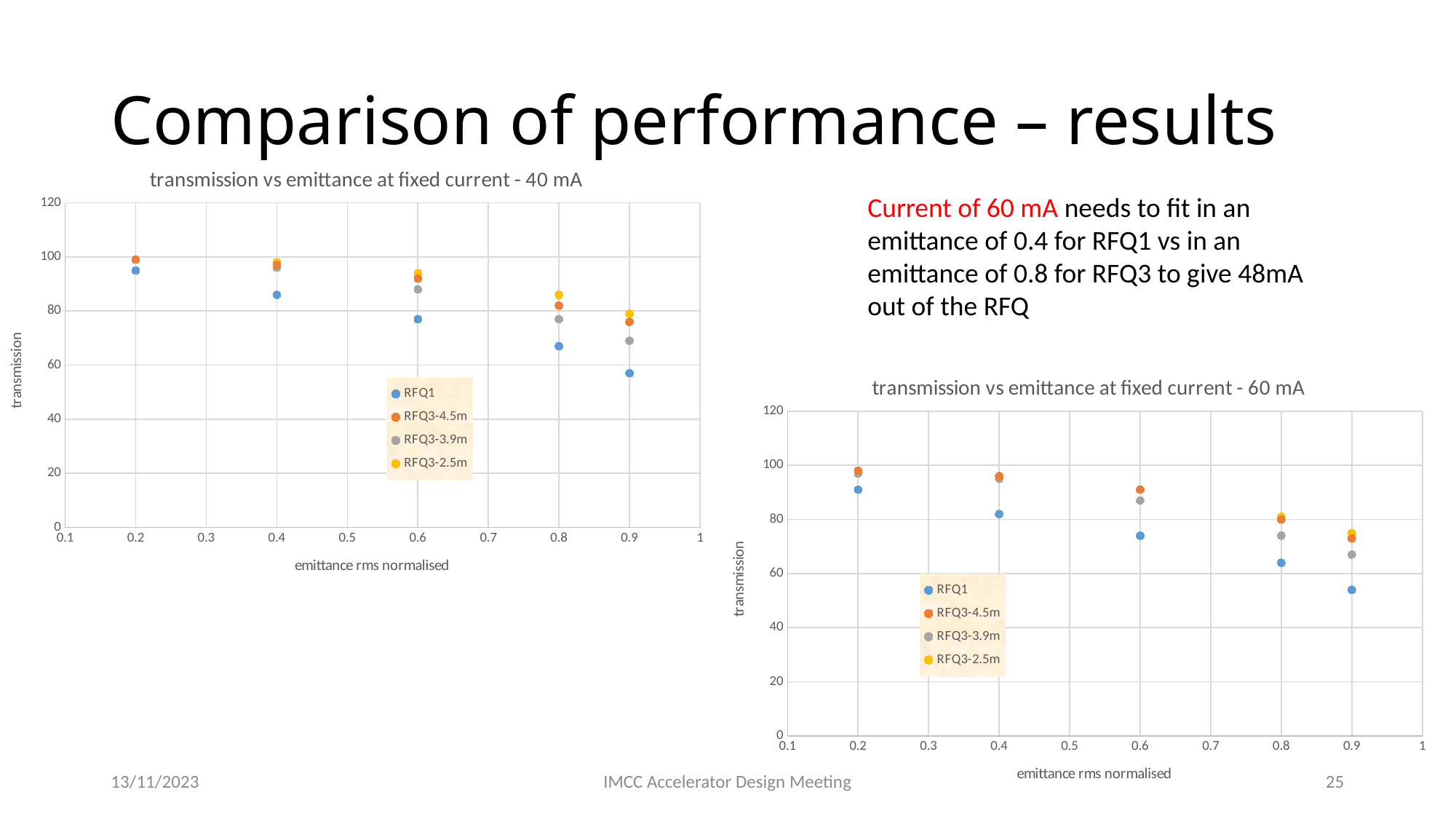
In the 'transmission vs emittance at fixed current - 60 mA' chart, is the RFQ1 value at emittance 0.6 greater or less than 80? less How many series does the legend list in the 'transmission vs emittance at fixed current - 60 mA' chart? 4 In the 'transmission vs emittance at fixed current - 60 mA' chart, which series has the lowest transmission at emittance 0.9? RFQ1 In the 'transmission vs emittance at fixed current - 40 mA' chart, is the RFQ3-2.5m value at emittance 0.8 greater or less than 80? greater In the 'transmission vs emittance at fixed current - 60 mA' chart, is the RFQ3-3.9m value at emittance 0.9 greater or less than 60? greater In the 'transmission vs emittance at fixed current - 40 mA' chart, which is larger at emittance 0.6: RFQ1 or RFQ3-3.9m? RFQ3-3.9m What is the x-axis label of the 'transmission vs emittance at fixed current - 60 mA' chart? emittance rms normalised What kind of chart is the 'transmission vs emittance at fixed current - 40 mA' chart? scatter chart In the 'transmission vs emittance at fixed current - 40 mA' chart, does the RFQ1 transmission rise or fall as emittance increases? fall What is the title of the chart on the left of the slide? transmission vs emittance at fixed current - 40 mA In the 'transmission vs emittance at fixed current - 40 mA' chart, how many emittance values are plotted for the RFQ1 series? 5